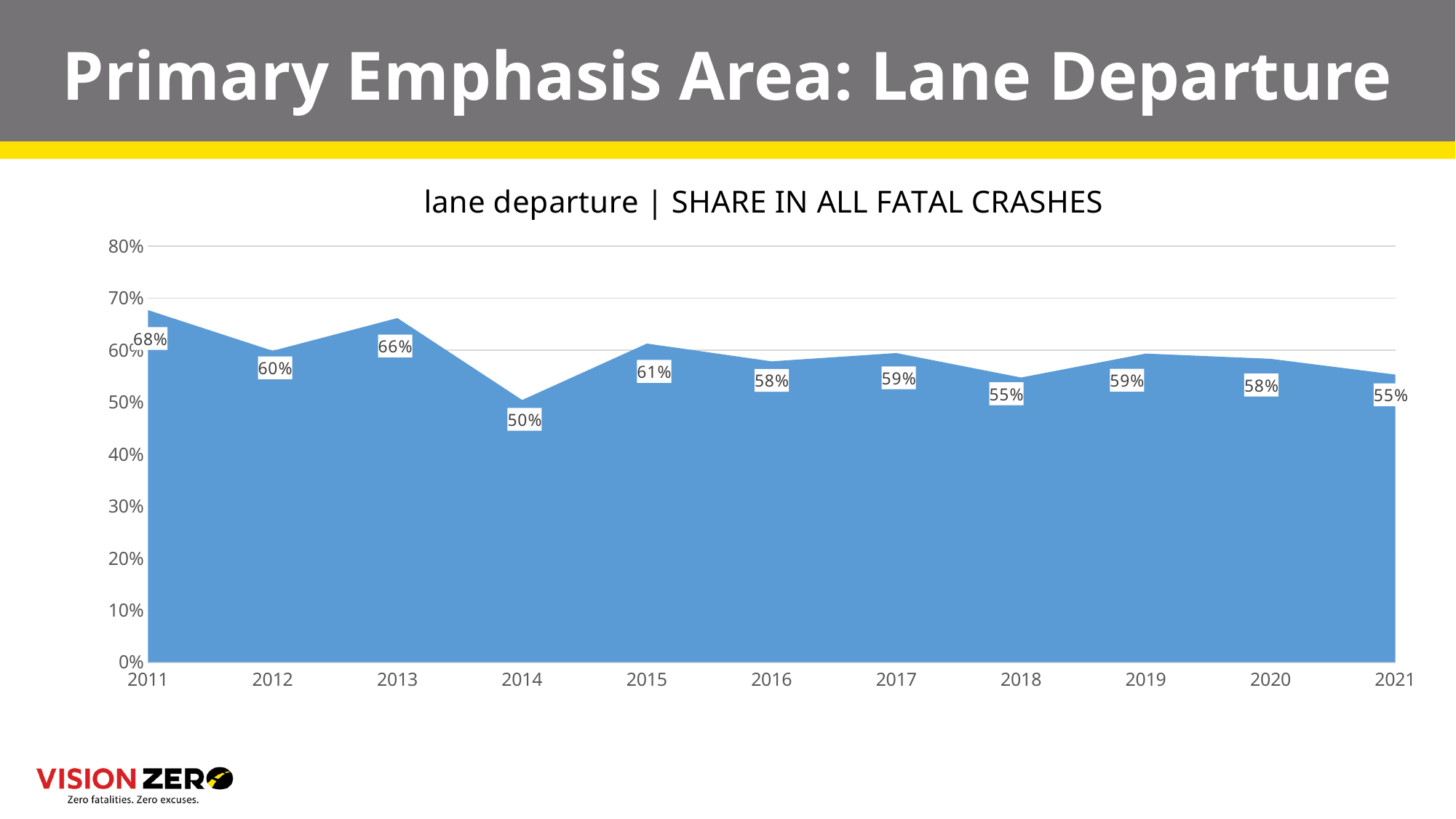
What is the lane departure share in all fatal crashes for 2011? 68% What kind of chart is shown on the slide? Area chart Which year has the highest lane departure share in all fatal crashes? 2011 How many years are shown on the x axis of the chart? 11 What is the difference between the lane departure share in 2011 and in 2014? 18% Which year has the lowest lane departure share in all fatal crashes? 2014 What is the lane departure share in all fatal crashes for 2021? 55% What is the title of the chart? lane departure | SHARE IN ALL FATAL CRASHES What is the lane departure share in all fatal crashes for 2017? 59% Which year has a larger lane departure share, 2013 or 2015? 2013 Does the lane departure share rise or fall from 2013 to 2014? Fall What is the lane departure share in all fatal crashes for 2014? 50%